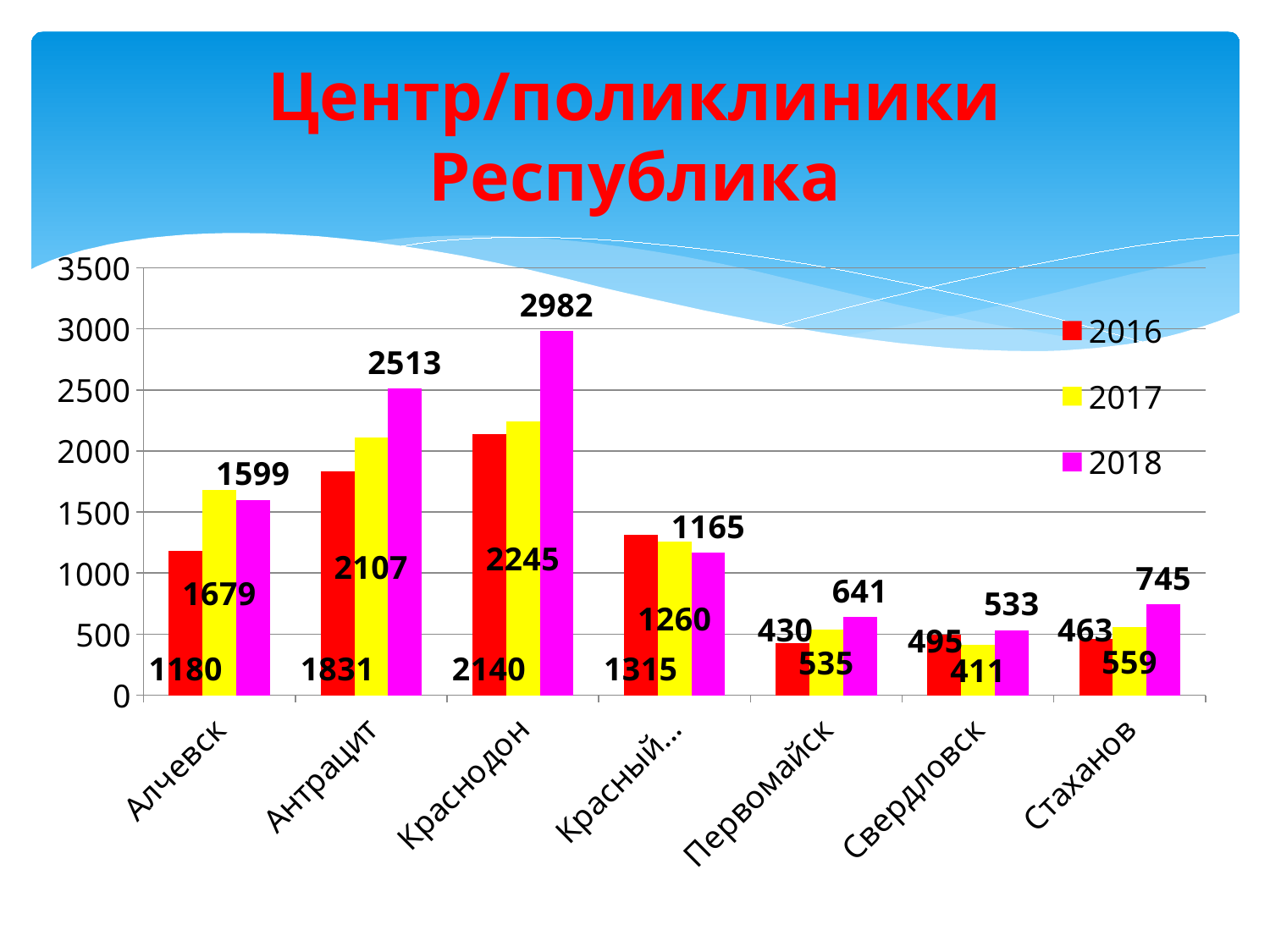
Which category has the highest value in the 2018 series? Краснодон What kind of chart is shown on the slide? bar chart How many series does the legend list? 3 Do the values for Первомайск rise or fall from 2016 to 2018? rise What is the value for Краснодон in 2018? 2982 What is the value for Алчевск in 2016? 1180 Is the 2017 value for Краснодон greater or less than 2000? greater For Алчевск, which year has the larger value, 2017 or 2018? 2017 How many categories are shown on the x axis? 7 Which category has the lowest value in the 2017 series? Свердловск What is the difference between the 2018 and 2016 values for Антрацит? 682 What is the value for Стаханов in 2017? 559